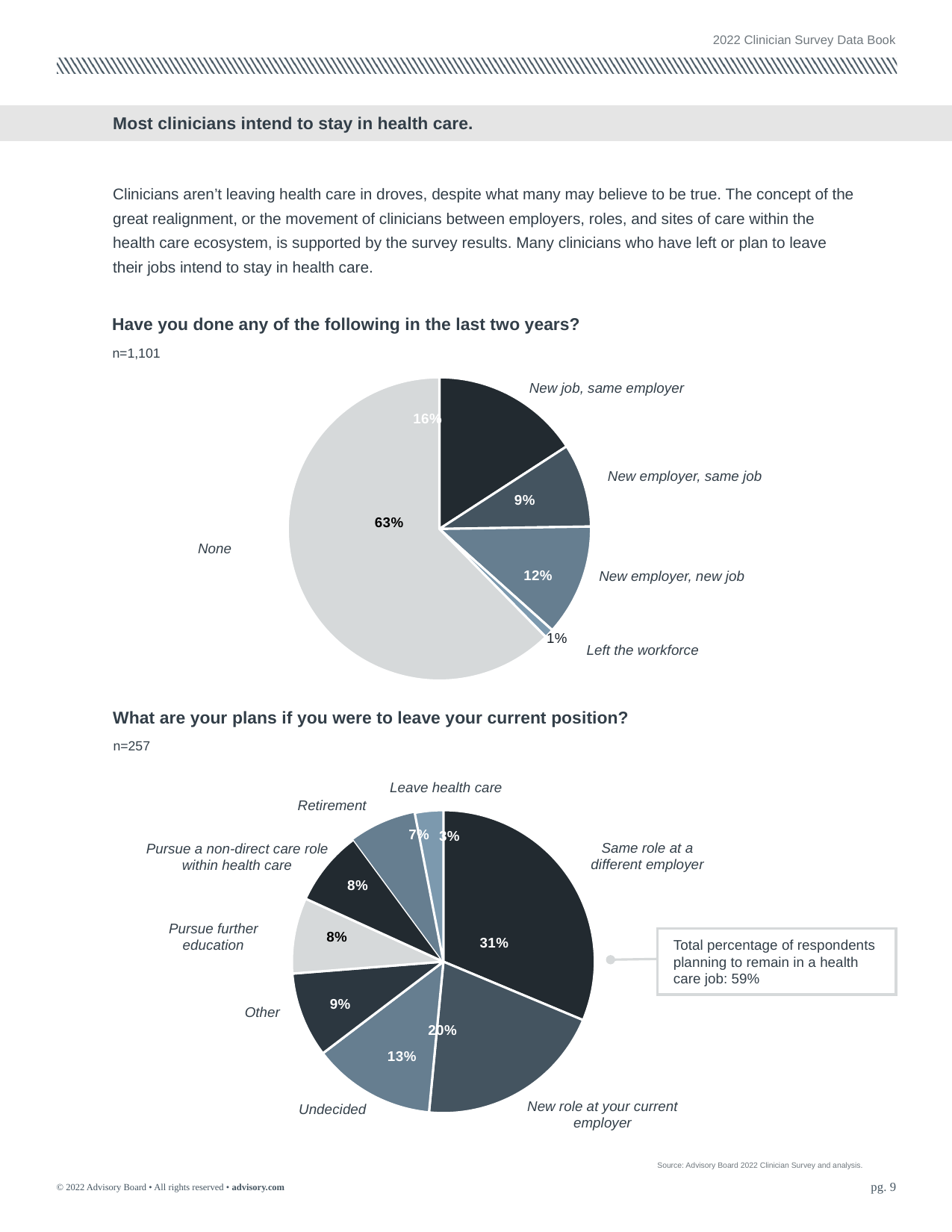
What is the sample size (n) for the chart 'What are your plans if you were to leave your current position?' n=257 In the chart 'Have you done any of the following in the last two years?', which category has the smallest slice? Left the workforce In the chart 'Have you done any of the following in the last two years?', what percentage took a new job with the same employer? 16% In the chart 'What are your plans if you were to leave your current position?', what percentage chose 'Same role at a different employer'? 31% In the chart 'Have you done any of the following in the last two years?', what is the difference between 'New employer, new job' and 'New employer, same job'? 3% In the chart 'What are your plans if you were to leave your current position?', what percentage chose 'Undecided'? 13% In the chart 'What are your plans if you were to leave your current position?', which is larger: 'Retirement' or 'Leave health care'? Retirement In the chart 'What are your plans if you were to leave your current position?', which category has the largest share? Same role at a different employer In the chart 'Have you done any of the following in the last two years?', how many categories are shown? 5 What type of chart is used for 'What are your plans if you were to leave your current position?' Pie chart In the chart 'Have you done any of the following in the last two years?', what percentage of respondents answered 'None'? 63% In the chart 'What are your plans if you were to leave your current position?', how many categories are shown? 8